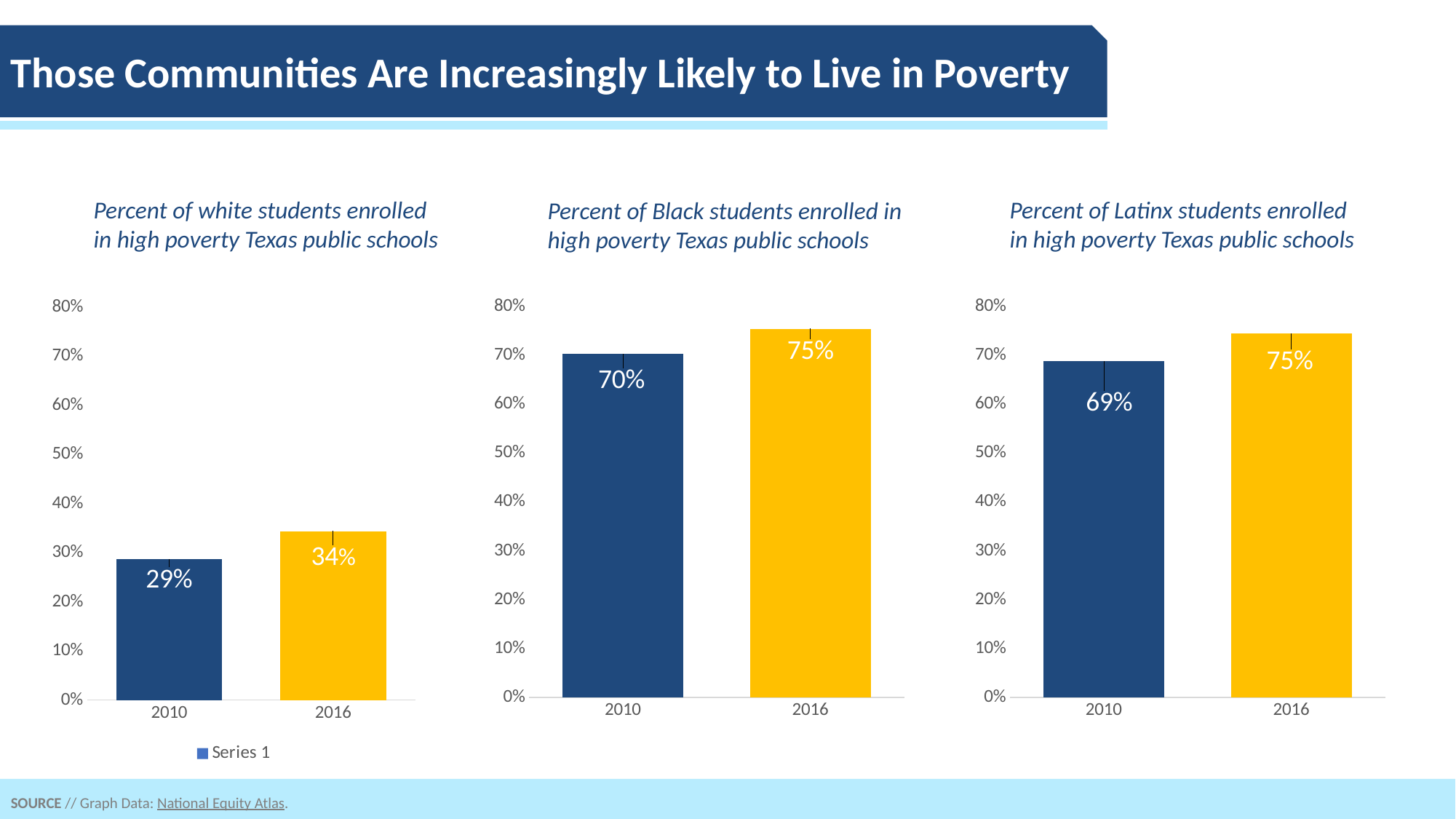
In the chart 'Percent of white students enrolled in high poverty Texas public schools', what is the value for 2010? 29% In the chart 'Percent of Black students enrolled in high poverty Texas public schools', what is the value for 2010? 70% In the chart 'Percent of Latinx students enrolled in high poverty Texas public schools', what is the value for 2016? 75% In the chart 'Percent of Black students enrolled in high poverty Texas public schools', which year has the higher value? 2016 In the chart 'Percent of Latinx students enrolled in high poverty Texas public schools', what is the value for 2010? 69% In the chart 'Percent of white students enrolled in high poverty Texas public schools', what is the value for 2016? 34% What kind of chart is the 'Percent of Latinx students enrolled in high poverty Texas public schools' chart? bar chart In the chart 'Percent of Latinx students enrolled in high poverty Texas public schools', what is the difference between the 2016 and 2010 values? 6% In the chart 'Percent of white students enrolled in high poverty Texas public schools', which year has the lower value? 2010 In the chart 'Percent of white students enrolled in high poverty Texas public schools', what is the difference between the 2016 and 2010 values? 5% How many bars are in the chart 'Percent of white students enrolled in high poverty Texas public schools'? 2 In the chart 'Percent of Black students enrolled in high poverty Texas public schools', do the values rise or fall from 2010 to 2016? rise